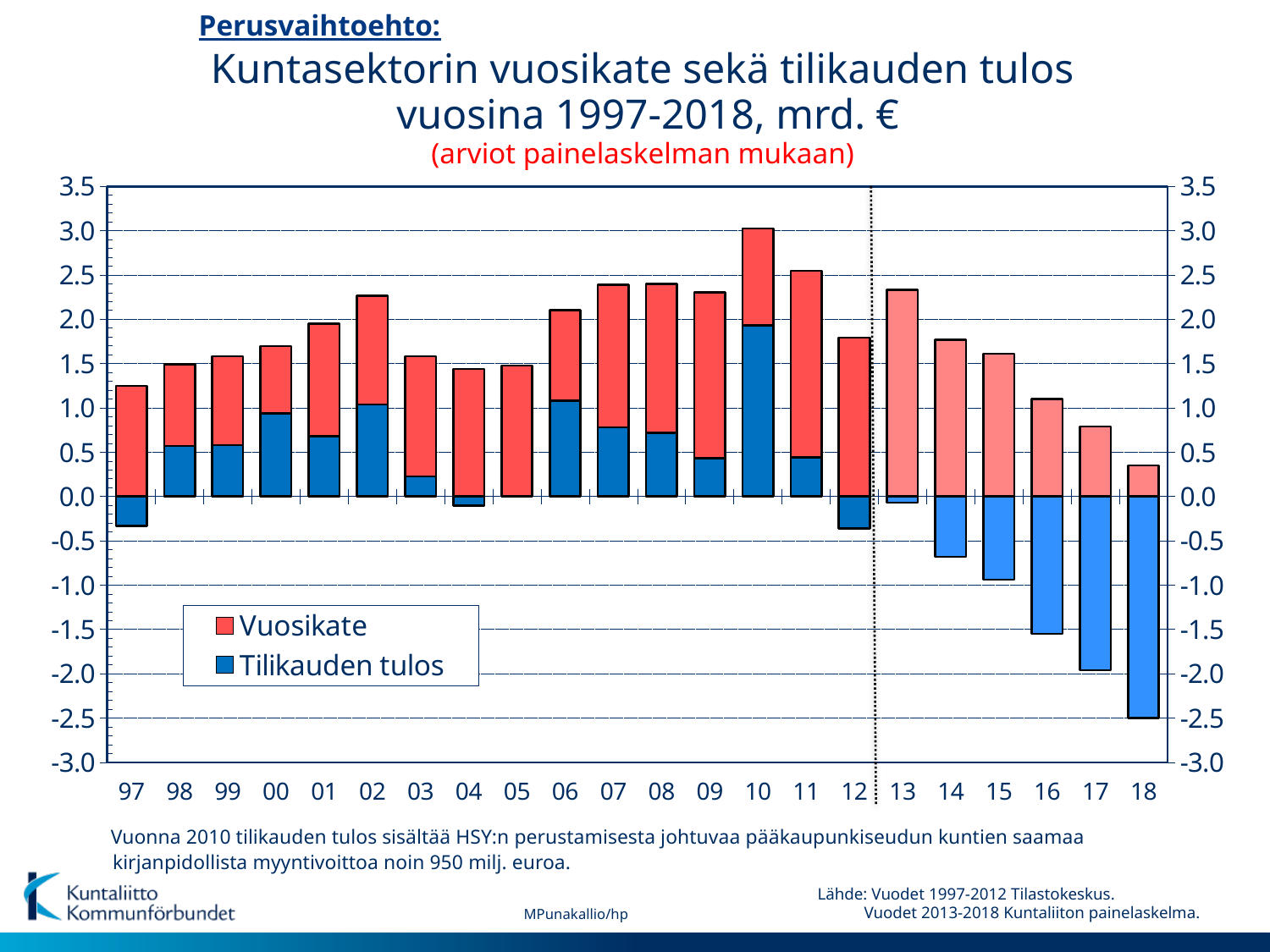
Which year has the lowest Tilikauden tulos value? 18 What kind of chart is shown on the slide? bar chart Is the Tilikauden tulos value for 18 greater or less than -2.0? less Which series is shown in blue in the legend? Tilikauden tulos Is the Vuosikate value for 18 greater or less than 0.5? less Which year has the highest Vuosikate value? 10 Which year has the highest Tilikauden tulos value? 10 Which is larger, the Vuosikate value for 02 or for 03? 02 How many years are shown on the x axis? 22 Do the Tilikauden tulos values rise or fall from 13 to 18? fall How many series does the legend list? 2